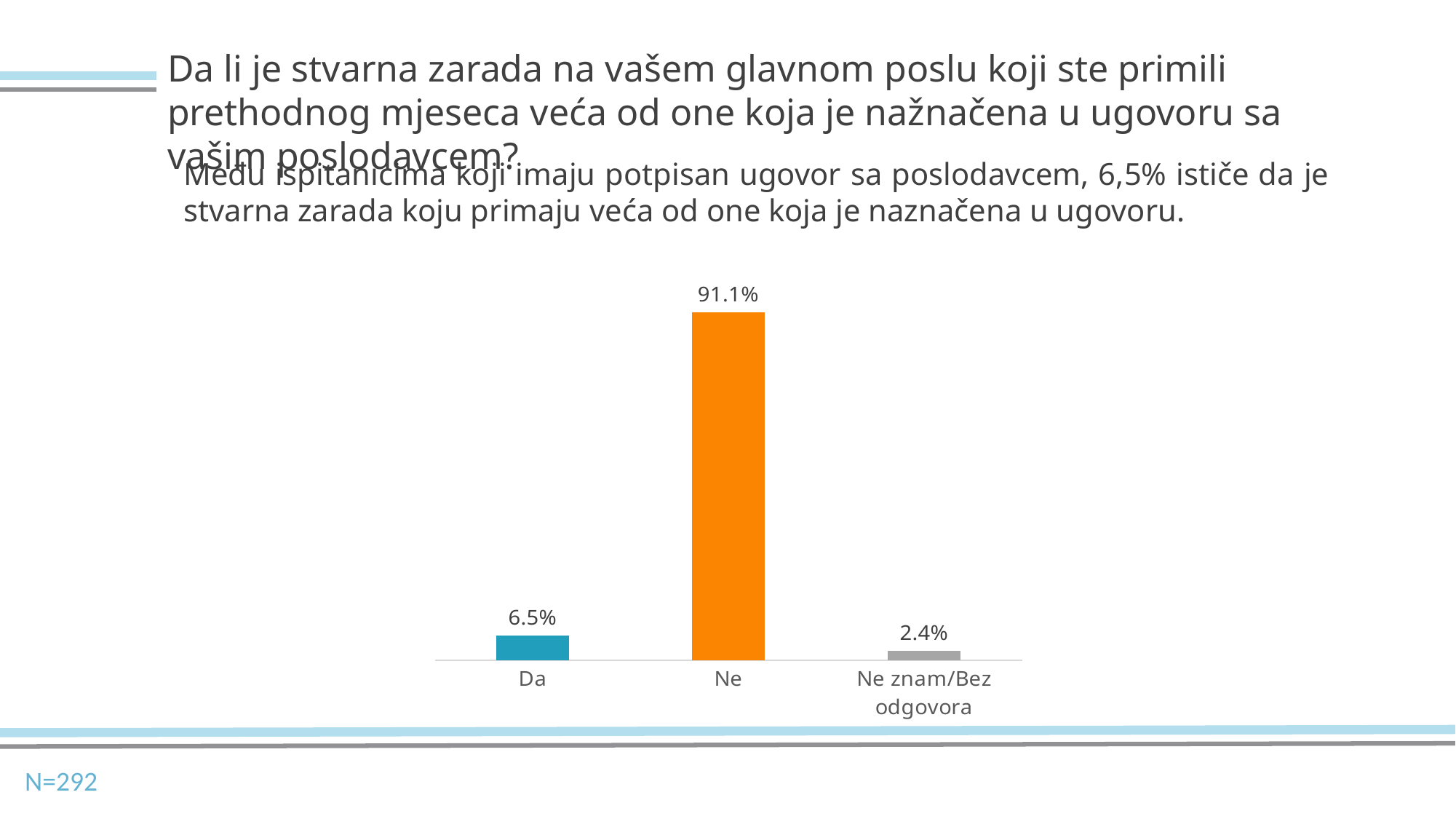
What colour is the bar for "Ne"? Orange What kind of chart is shown on the slide? Bar chart How many categories are shown on the chart? 3 Which category has the highest value? Ne Which category has the lowest value? Ne znam/Bez odgovora What sample size (N) is stated on the slide? N=292 Which is larger, the value for "Da" or the value for "Ne znam/Bez odgovora"? Da What is the value for "Ne"? 91.1% What is the difference between the values for "Ne" and "Da"? 84.6% What is the difference between the values for "Da" and "Ne znam/Bez odgovora"? 4.1% What is the value for "Da"? 6.5% What is the value for "Ne znam/Bez odgovora"? 2.4%